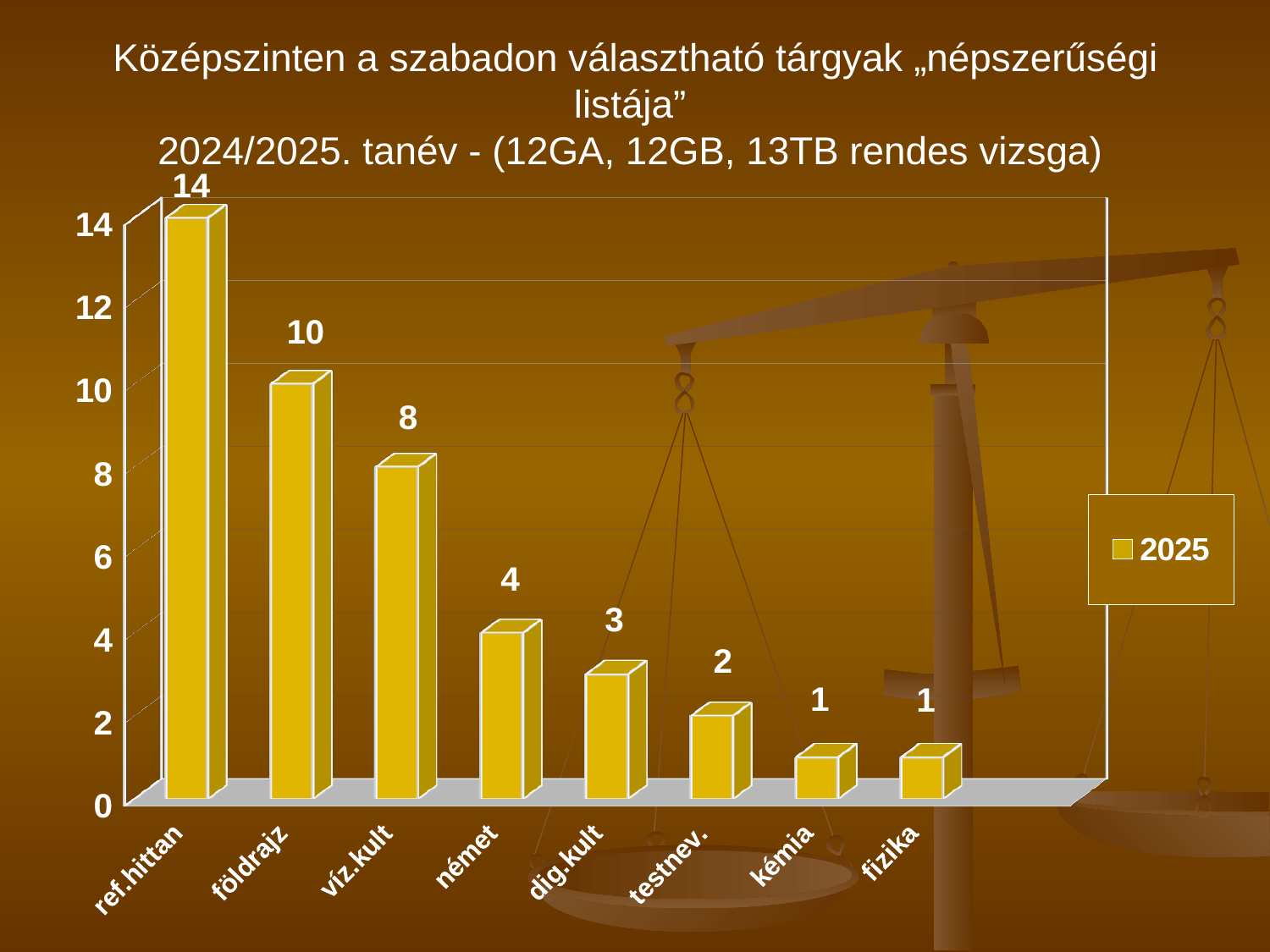
What kind of chart is shown on the slide? bar chart Do the values rise or fall from left to right along the x axis? fall Which is larger, the value for víz.kult or the value for német? víz.kult How many categories are shown on the x axis? 8 What is the difference between the values for ref.hittan and víz.kult? 6 What is the value for német? 4 What is the difference between the values for földrajz and testnev.? 8 What is the legend entry shown on the chart? 2025 What is the value for földrajz? 10 What is the value for dig.kult? 3 How many series does the legend list? 1 Which category has the highest value? ref.hittan